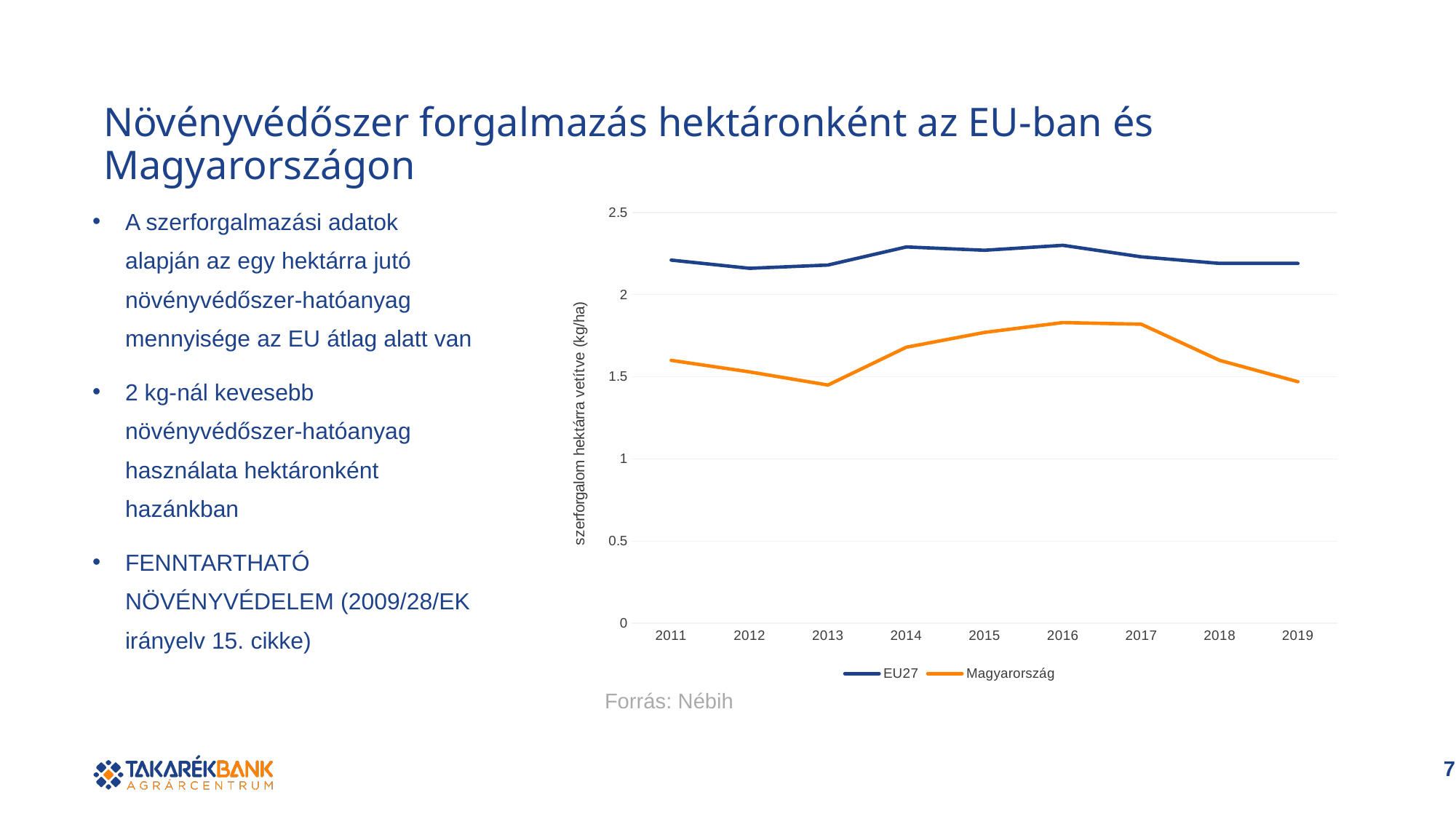
Which series has the lower value in 2011, EU27 or Magyarország? Magyarország How many years are plotted along the x axis of the chart? 9 Is the value for EU27 in 2016 greater or less than 2.5? less Does the Magyarország line rise or fall from 2013 to 2016? rise Is the value for Magyarország in 2013 greater or less than 1.5? less How many series does the chart legend list? 2 Is the value for Magyarország in 2016 greater or less than 1.5? greater What kind of chart is shown on the slide? line chart What is the label of the chart's y axis? szerforgalom hektárra vetítve (kg/ha) Does the Magyarország line rise or fall from 2017 to 2019? fall Which series has the higher value in 2016, EU27 or Magyarország? EU27